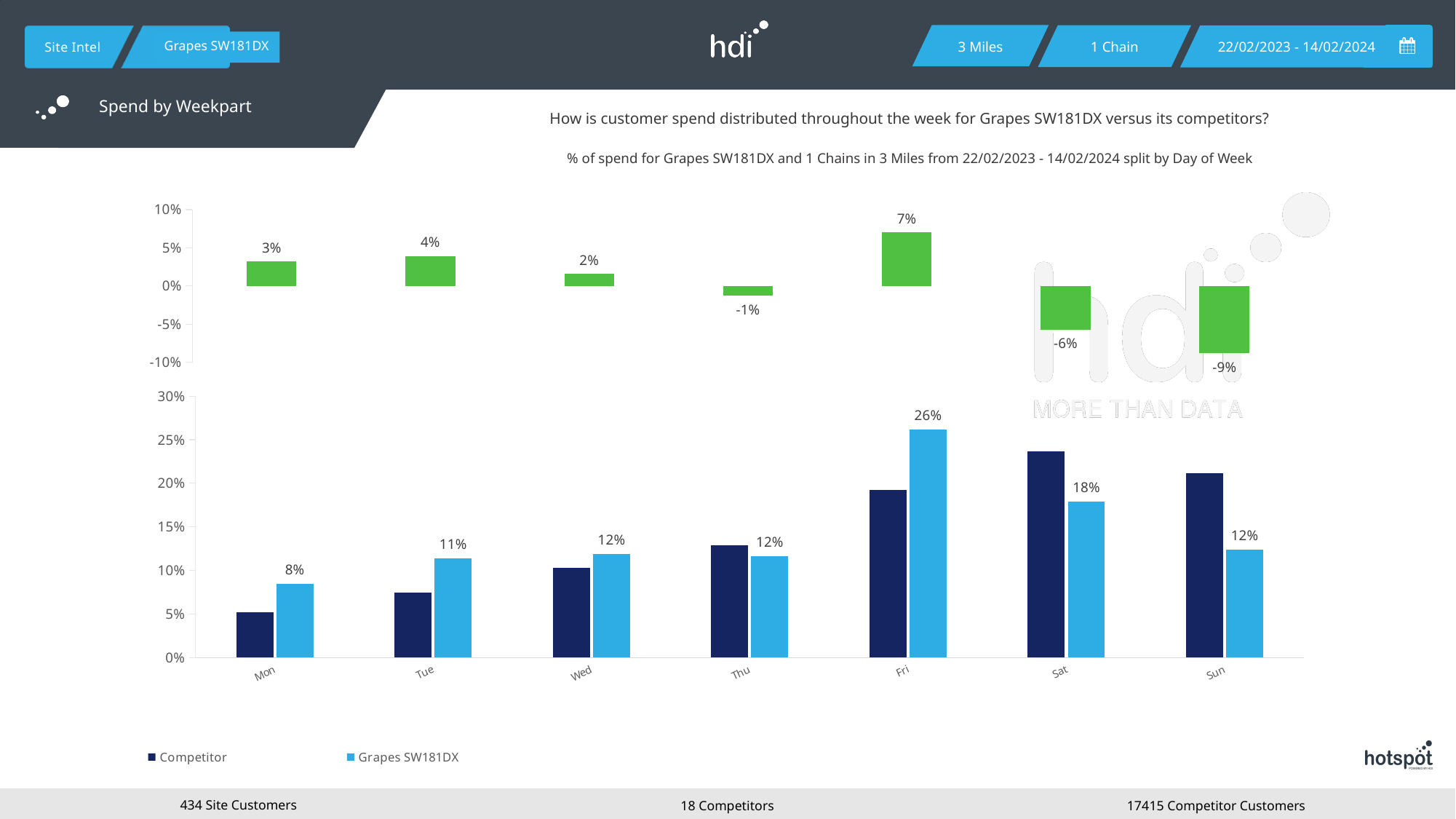
In the top chart, which day has the highest value? Fri In the bottom chart, is the Competitor value for Sat greater or less than 20%? greater In the bottom chart, what is the value for Grapes SW181DX on Fri? 26% In the bottom chart, what is the difference between the Grapes SW181DX values for Fri and Sat? 8% In the bottom chart, is the Competitor value for Mon greater or less than 10%? less In the bottom chart, on which day is the Grapes SW181DX value lowest? Mon How many series does the legend of the bottom chart list? 2 In the bottom chart, on Sat, which is larger: the Competitor value or the Grapes SW181DX value? Competitor How many days of the week are shown on the x axis of the bottom chart? 7 In the bottom chart, on which day is the Grapes SW181DX value highest? Fri In the top chart, what is the value shown for Sun? -9% What kind of chart is the bottom chart? Bar chart